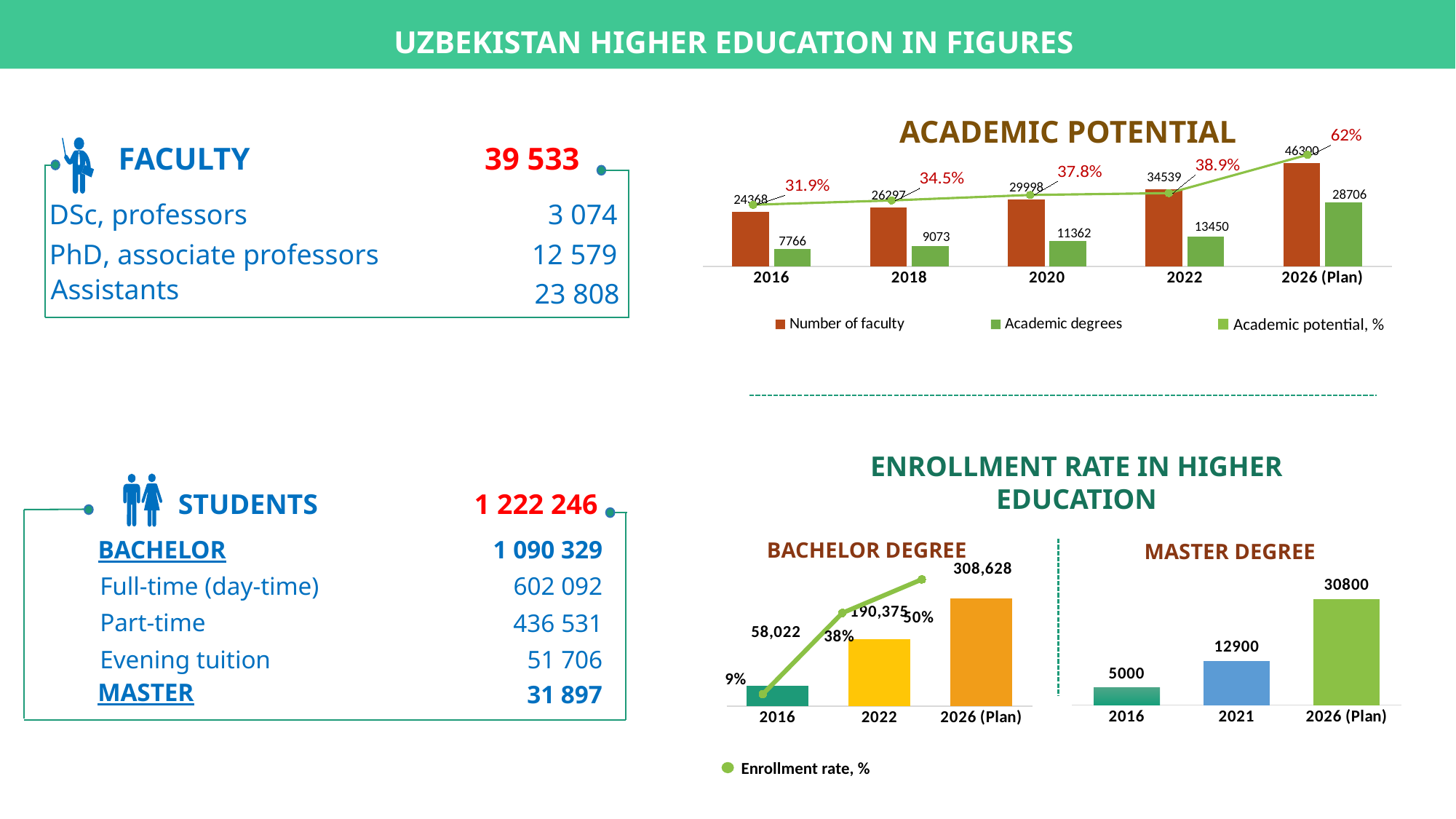
How many series does the legend of the Academic Potential chart list? 3 In the Bachelor Degree chart, what is the value for 2022? 190,375 In the Academic Potential chart, what is the Academic potential, % for 2026 (Plan)? 62% In the Academic Potential chart, what is the Number of faculty for 2020? 29998 In the Academic Potential chart, what is the value for Academic degrees in 2022? 13450 How many categories are shown on the x axis of the Bachelor Degree chart? 3 In the Bachelor Degree chart, what is the Enrollment rate, % for 2016? 9% In the Academic Potential chart, what is the difference in Number of faculty between 2026 (Plan) and 2022? 11761 In the Academic Potential chart, does the Academic potential, % line rise or fall from 2016 to 2026 (Plan)? rise What kind of chart is the Master Degree chart? bar chart In the Master Degree chart, which year has the highest value? 2026 (Plan) In the Master Degree chart, what is the difference between the 2021 and 2016 values? 7900